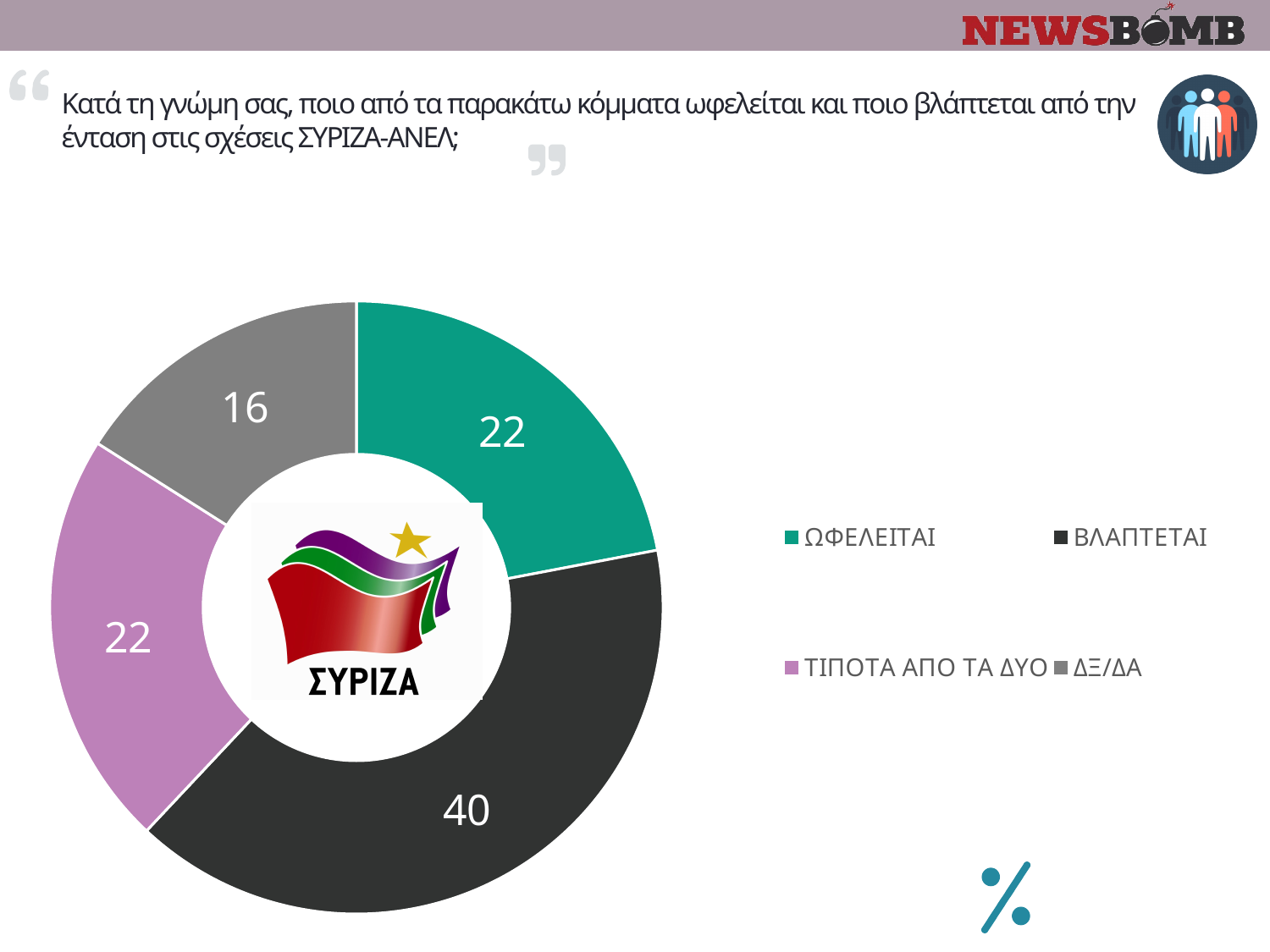
What value is shown for the ΔΞ/ΔΑ slice? 16 Which category has the largest slice? ΒΛΑΠΤΕΤΑΙ What value is shown for the ΤΙΠΟΤΑ ΑΠΟ ΤΑ ΔΥΟ slice? 22 Which is larger, the ΒΛΑΠΤΕΤΑΙ slice or the ΔΞ/ΔΑ slice? ΒΛΑΠΤΕΤΑΙ What is the difference between the ΒΛΑΠΤΕΤΑΙ value and the ΩΦΕΛΕΙΤΑΙ value? 18 What kind of chart is shown on the slide? Pie chart (doughnut) How many slices does the chart have? 4 Which category has the smallest slice? ΔΞ/ΔΑ What is the difference between the ΒΛΑΠΤΕΤΑΙ value and the ΔΞ/ΔΑ value? 24 What colour is the ΤΙΠΟΤΑ ΑΠΟ ΤΑ ΔΥΟ slice? Purple What value is shown for the ΒΛΑΠΤΕΤΑΙ slice? 40 What value is shown for the ΩΦΕΛΕΙΤΑΙ slice? 22